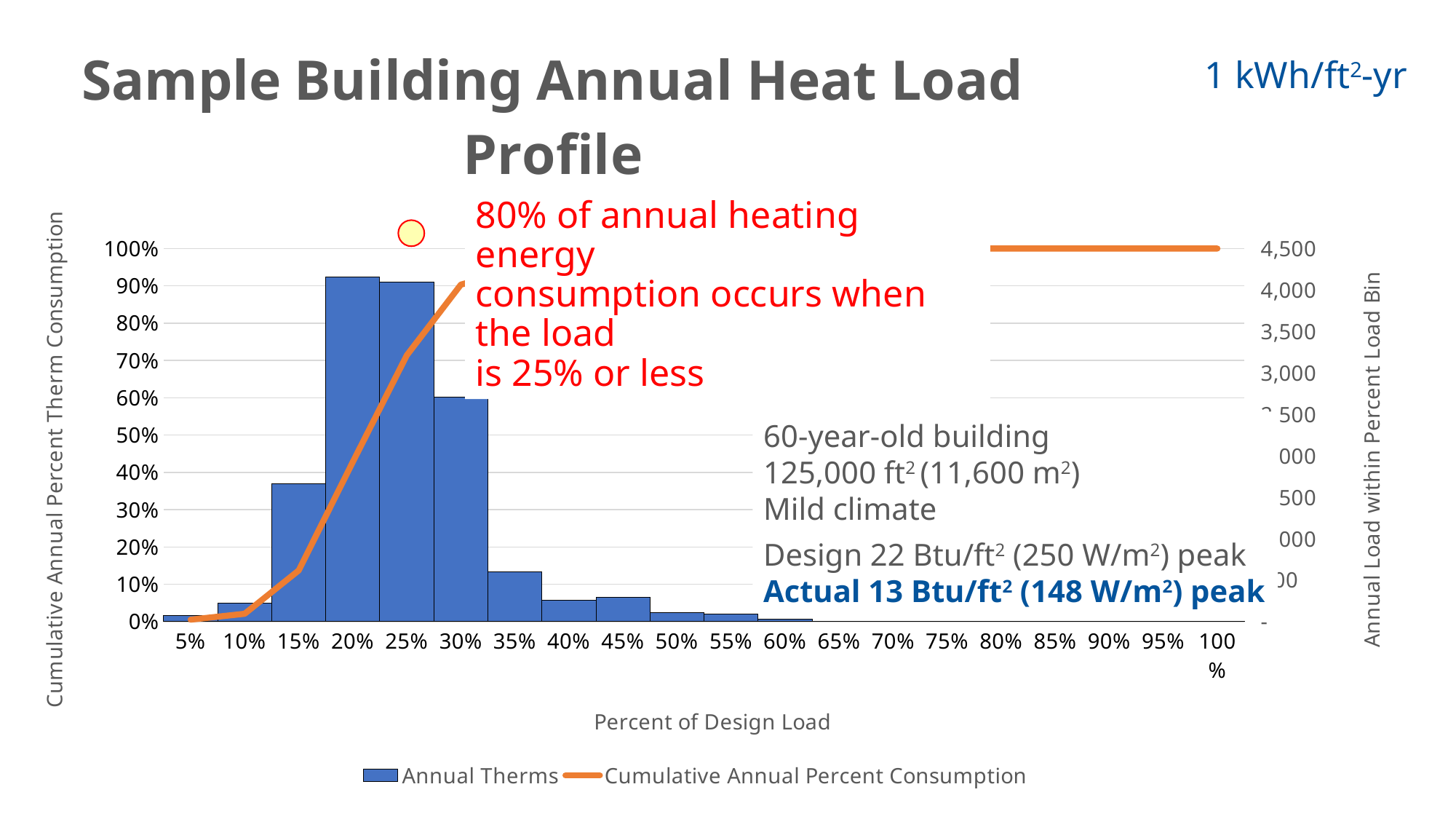
Is the Cumulative Annual Percent Consumption value at the 30% bin greater or less than 80%? greater How many percent-of-design-load categories are shown on the x axis? 20 Which percent-of-design-load bin has the tallest Annual Therms bar? 20% Is the Cumulative Annual Percent Consumption value at the 25% bin greater or less than 60%? greater How many series does the chart legend list? 2 Does the Cumulative Annual Percent Consumption line rise or fall as the percent of design load increases from 5% to 30%? rises What kind of chart is shown on the slide? A combined bar and line chart Is the Cumulative Annual Percent Consumption value at the 15% bin greater or less than 20%? less Which has the taller Annual Therms bar, the 15% bin or the 30% bin? 30% What are the two series named in the chart legend? Annual Therms and Cumulative Annual Percent Consumption What is the title of the chart's x axis? Percent of Design Load Which has the taller Annual Therms bar, the 20% bin or the 35% bin? 20%